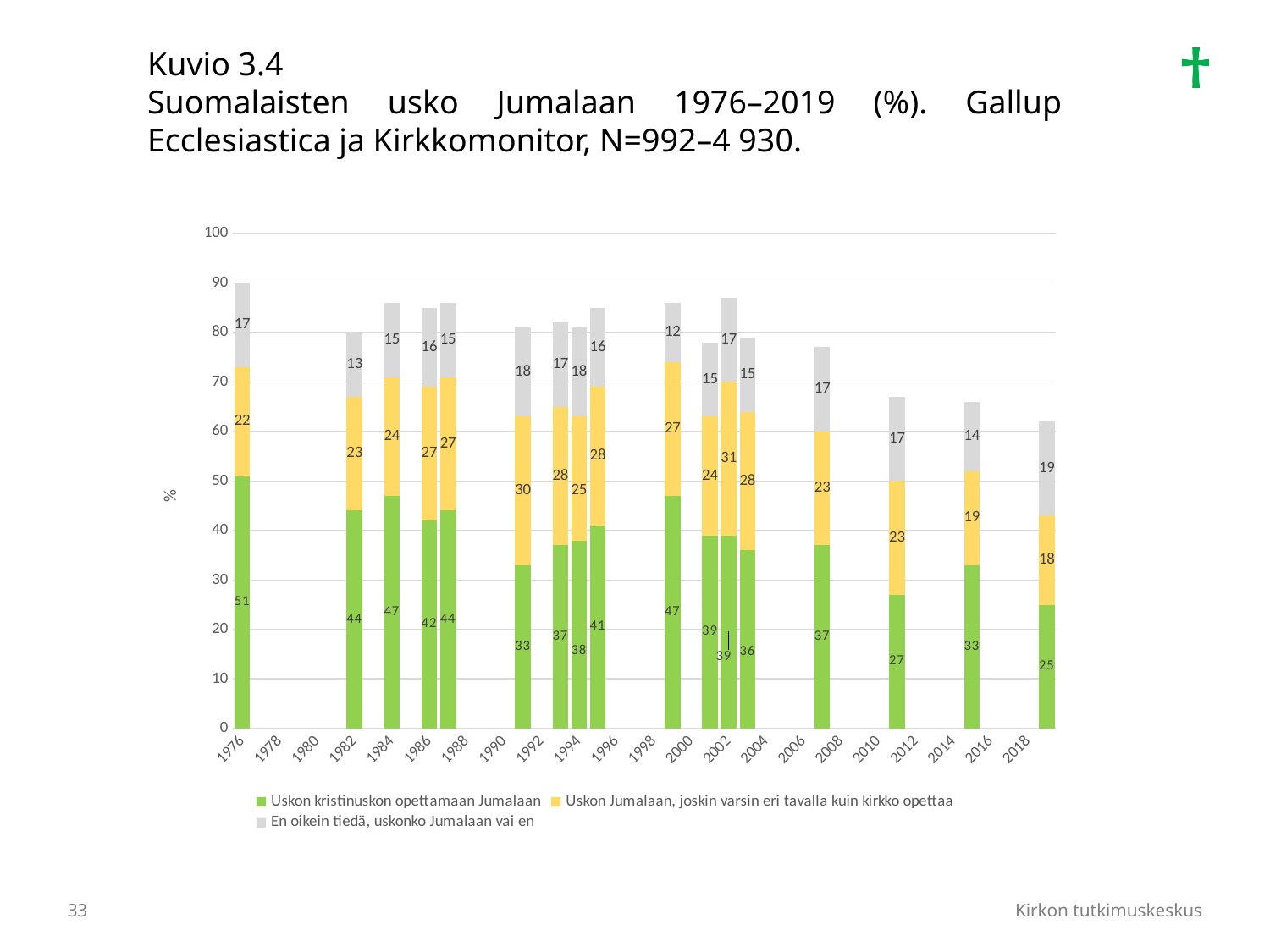
What is the total of the stacked bar for 1976? 90 Which is larger, the 'Uskon kristinuskon opettamaan Jumalaan' value for 1984 or for 1986? 1984 What is the value of 'Uskon Jumalaan, joskin varsin eri tavalla kuin kirkko opettaa' for 1982? 23 What is the value of 'Uskon kristinuskon opettamaan Jumalaan' for 1976? 51 Does 'Uskon kristinuskon opettamaan Jumalaan' generally rise or fall from 1976 to 2019? fall What is the difference between the 'Uskon kristinuskon opettamaan Jumalaan' values for 1976 and 1982? 7 What kind of chart is shown on the slide? stacked bar chart In which year is 'Uskon kristinuskon opettamaan Jumalaan' highest? 1976 What is the value of 'En oikein tiedä, uskonko Jumalaan vai en' for 1984? 15 What is the value of 'Uskon kristinuskon opettamaan Jumalaan' in the rightmost bar (2019)? 25 What is the total of the stacked bar for 1982? 80 How many series does the legend list? 3